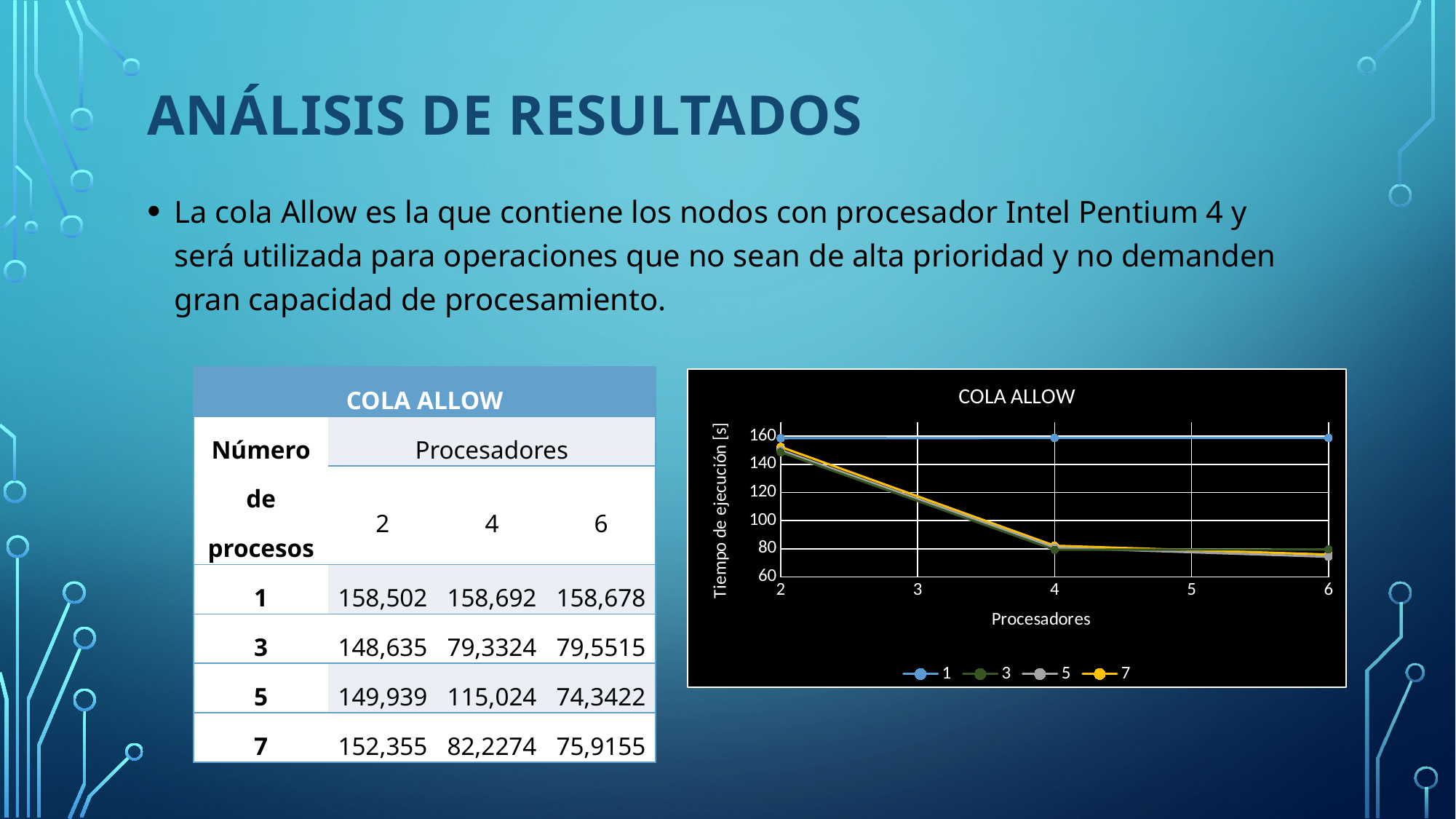
Is the value for series 1 at 6 processors greater or less than 140? greater What is the label of the y axis of the chart? Tiempo de ejecución [s] What is the title of the chart? COLA ALLOW Which series has the highest value at 6 processors? 1 Is the value for series 7 at 2 processors greater or less than 120? greater Is the value for series 3 at 4 processors greater or less than 100? less At 4 processors, which is larger: the value for series 1 or the value for series 3? series 1 Does the value for series 3 rise or fall as the number of processors increases from 2 to 6? fall How many series does the legend of the chart list? 4 How many data points are plotted for each series in the chart? 3 What type of chart is shown on the slide? line chart